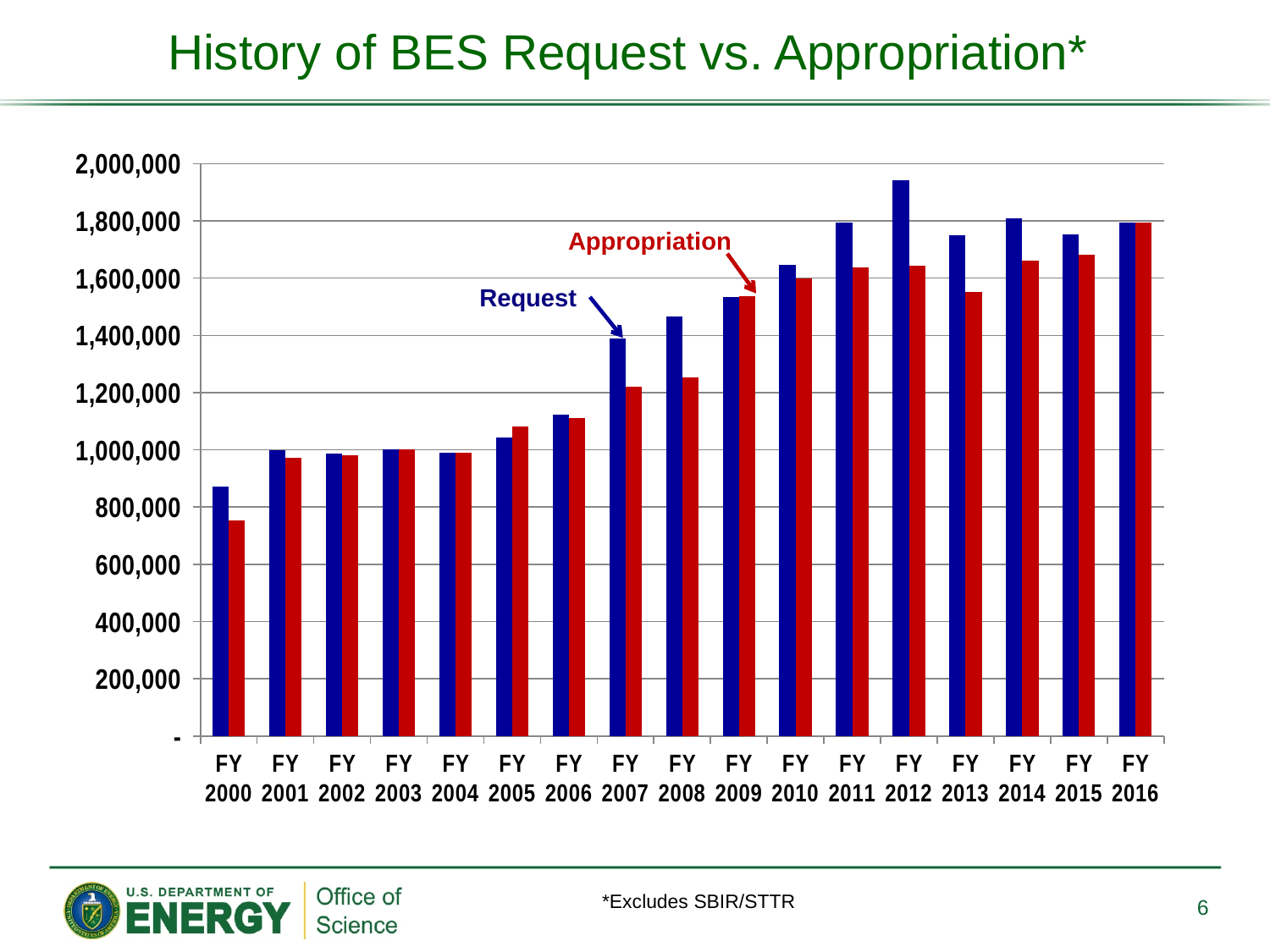
Is the Appropriation value for FY 2000 greater or less than 800,000? less For FY 2008, which is larger, the Request or the Appropriation? Request In which fiscal year is the Appropriation value lowest? FY 2000 In which fiscal year is the Request value lowest? FY 2000 Is the Request value for FY 2012 greater or less than 1,800,000? greater How many data series does the chart show? 2 What colour are the Request bars? Blue How many fiscal years are shown on the x axis? 17 In which fiscal year is the Request value highest? FY 2012 For FY 2005, which is larger, the Request or the Appropriation? Appropriation Is the Appropriation value for FY 2013 greater or less than 1,600,000? less What kind of chart is shown on the slide? Bar chart